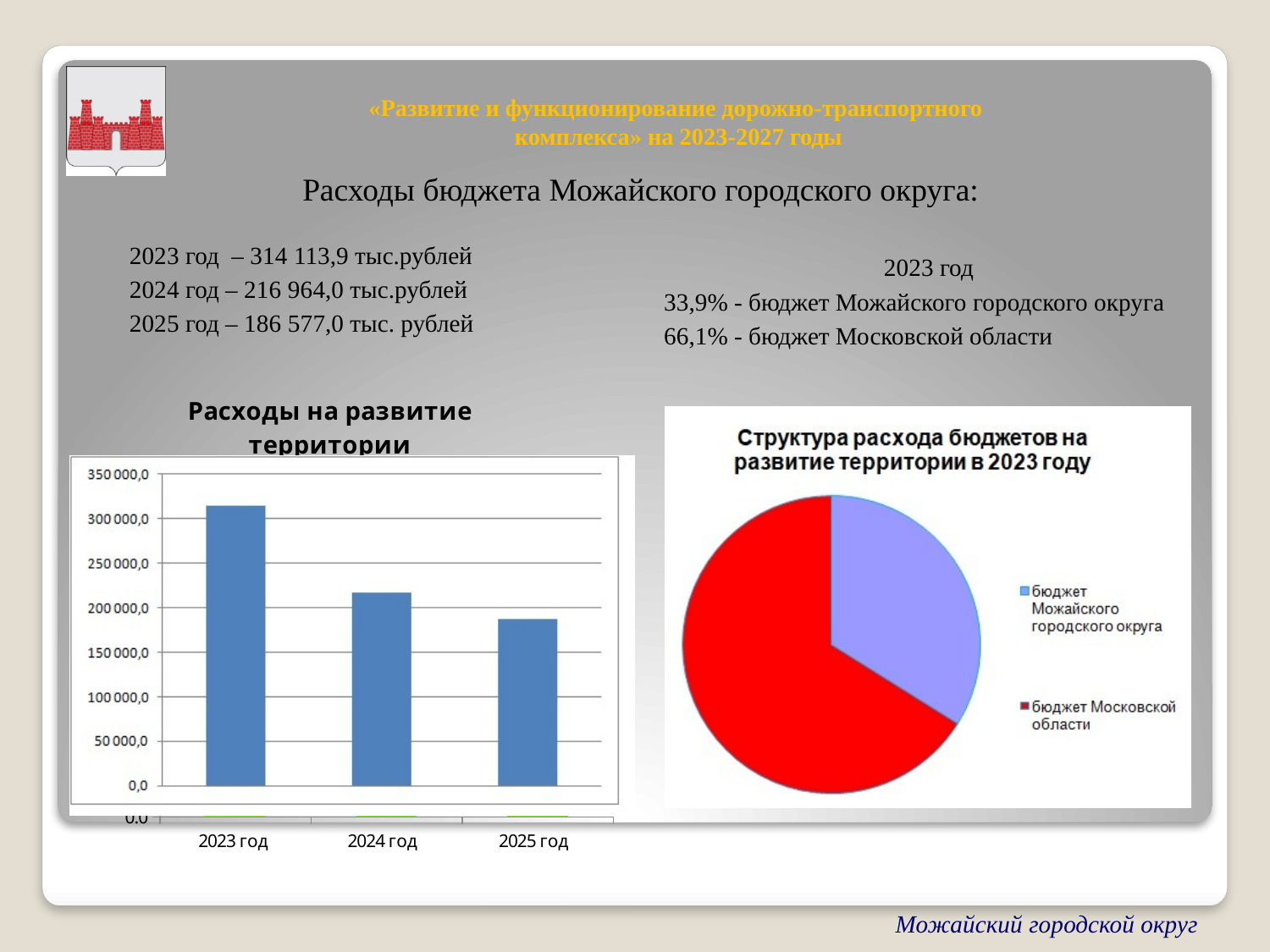
What kind of chart is the chart titled "Структура расхода бюджетов на развитие территории в 2023 году"? pie chart In the bar chart "Расходы на развитие территории", which is larger, the bar for 2024 год or the bar for 2025 год? 2024 год In the bar chart "Расходы на развитие территории", is the value for 2023 год greater or less than 300 000,0? greater In the bar chart "Расходы на развитие территории", is the value for 2025 год greater or less than 200 000,0? less In the bar chart "Расходы на развитие территории", which year has the lowest bar? 2025 год In the bar chart "Расходы на развитие территории", how many years are shown on the x axis? 3 What kind of chart is the chart titled "Расходы на развитие территории"? bar chart In the bar chart "Расходы на развитие территории", do the values rise or fall from 2023 to 2025? fall In the pie chart "Структура расхода бюджетов на развитие территории в 2023 году", how many entries does the legend list? 2 In the bar chart "Расходы на развитие территории", which year has the highest bar? 2023 год In the pie chart "Структура расхода бюджетов на развитие территории в 2023 году", what share does "бюджет Московской области" have? 66,1% In the pie chart "Структура расхода бюджетов на развитие территории в 2023 году", what colour is the slice for "бюджет Московской области"? red